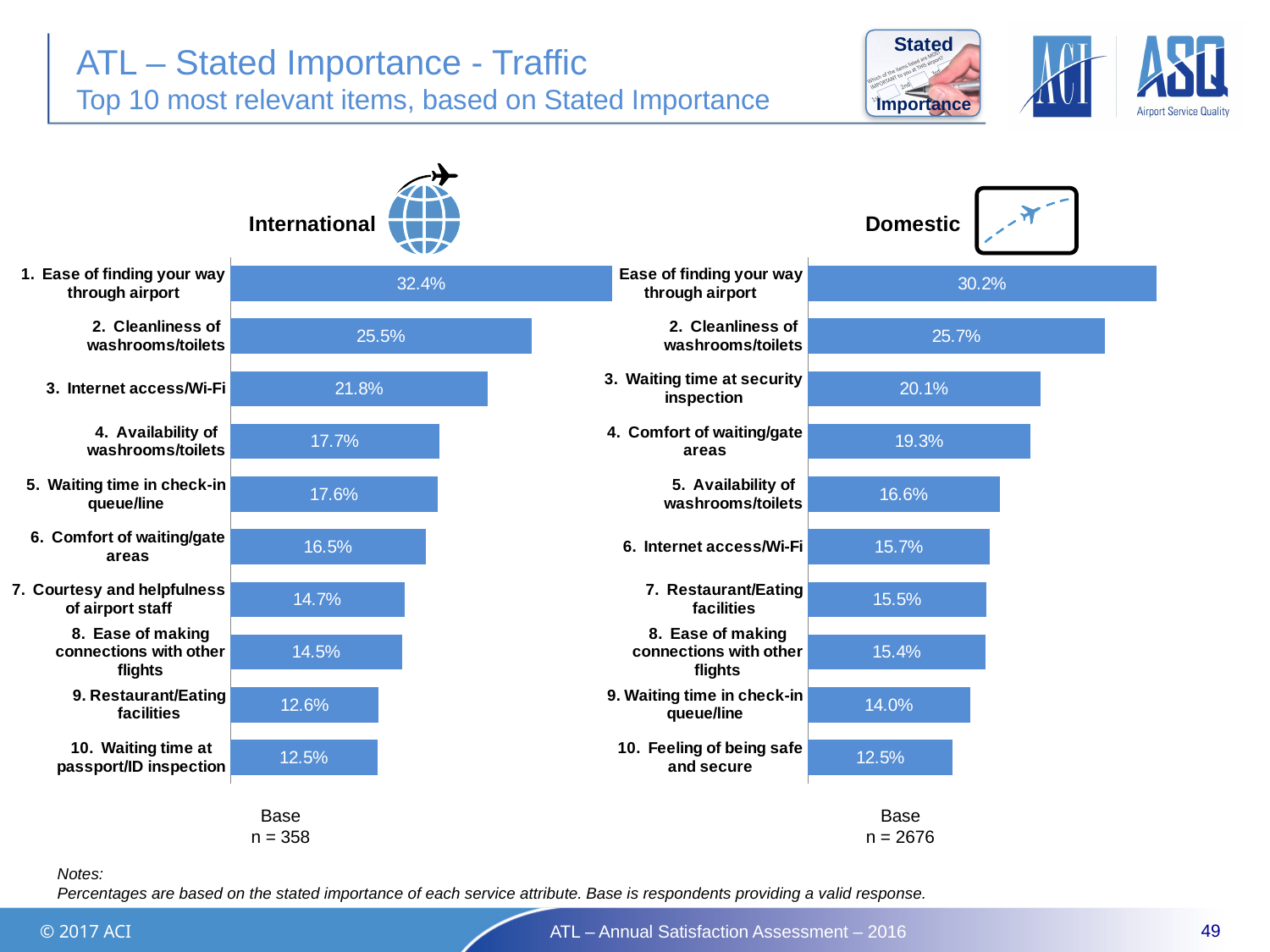
In the Domestic chart, what is the difference between Comfort of waiting/gate areas and Availability of washrooms/toilets? 2.7% Which is larger: Internet access/Wi-Fi in the International chart or Internet access/Wi-Fi in the Domestic chart? International In the Domestic chart, what is the value for Waiting time at security inspection? 20.1% In the International chart, what is the difference between Ease of finding your way through airport and Cleanliness of washrooms/toilets? 6.9% In the International chart, what is the value for Ease of finding your way through airport? 32.4% What kind of chart is the International chart? Bar chart In the International chart, which item has the lowest value? Waiting time at passport/ID inspection In the Domestic chart, what is the value for Feeling of being safe and secure? 12.5% What is the base (n) for the Domestic chart? n = 2676 How many items are shown in the Domestic chart? 10 In the Domestic chart, which item has the highest value? Ease of finding your way through airport In the International chart, what is the value for Internet access/Wi-Fi? 21.8%